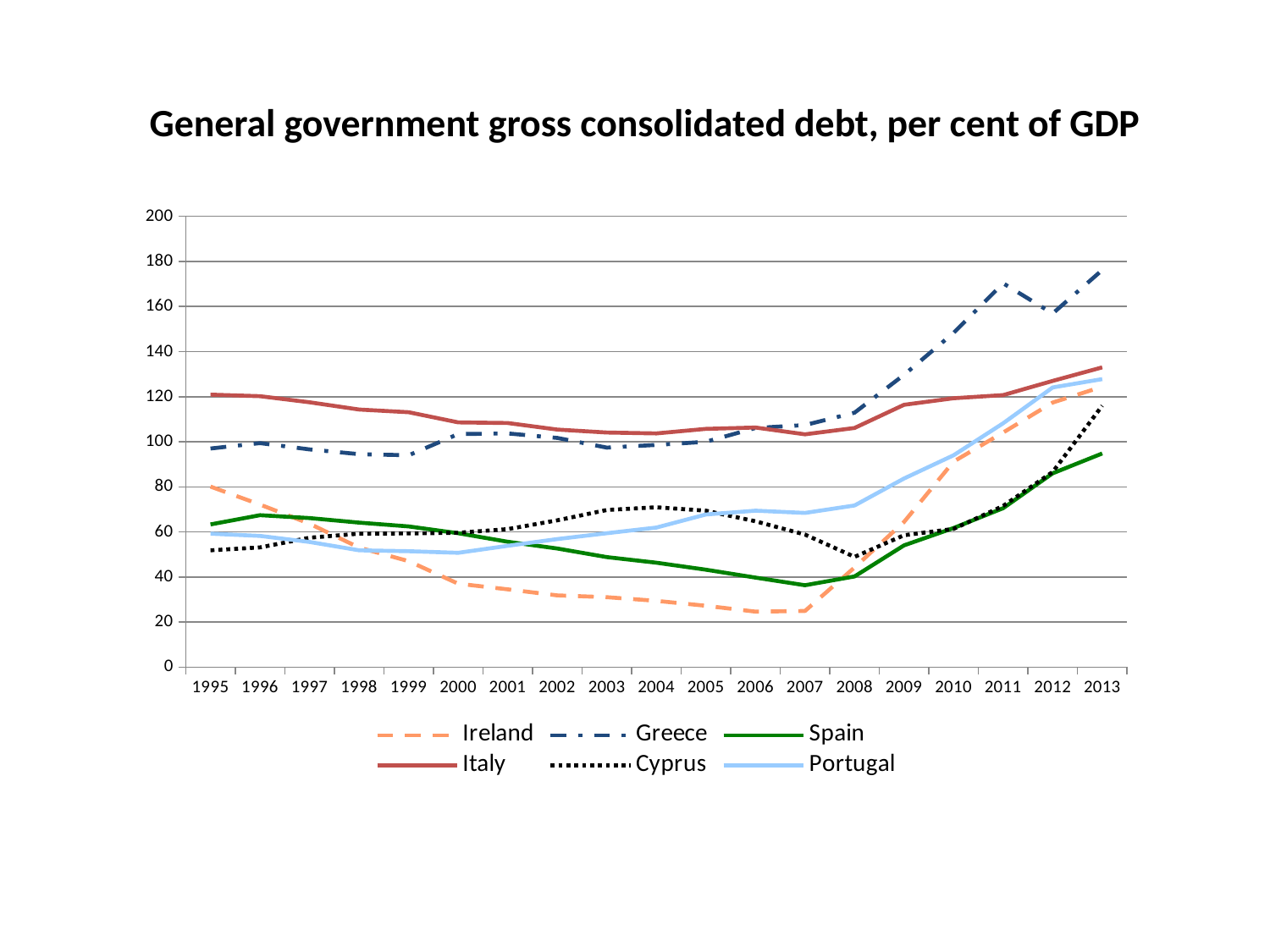
Does the value for Spain rise or fall between 2007 and 2013? rise Is the value for Ireland in 2007 greater or less than 40? less How many series does the legend list? 6 What is the title of the chart? General government gross consolidated debt, per cent of GDP Which country has the highest debt-to-GDP value in 2013? Greece How many years are shown along the x axis? 19 What kind of chart is shown on the slide? line chart In 2013, which is larger: the value for Italy or the value for Spain? Italy Is the value for Italy in 1995 greater or less than 100? greater Does the value for Ireland rise or fall between 1995 and 2007? fall Is the value for Greece in 2013 greater or less than 160? greater Which country has the lowest debt-to-GDP value in 2007? Ireland